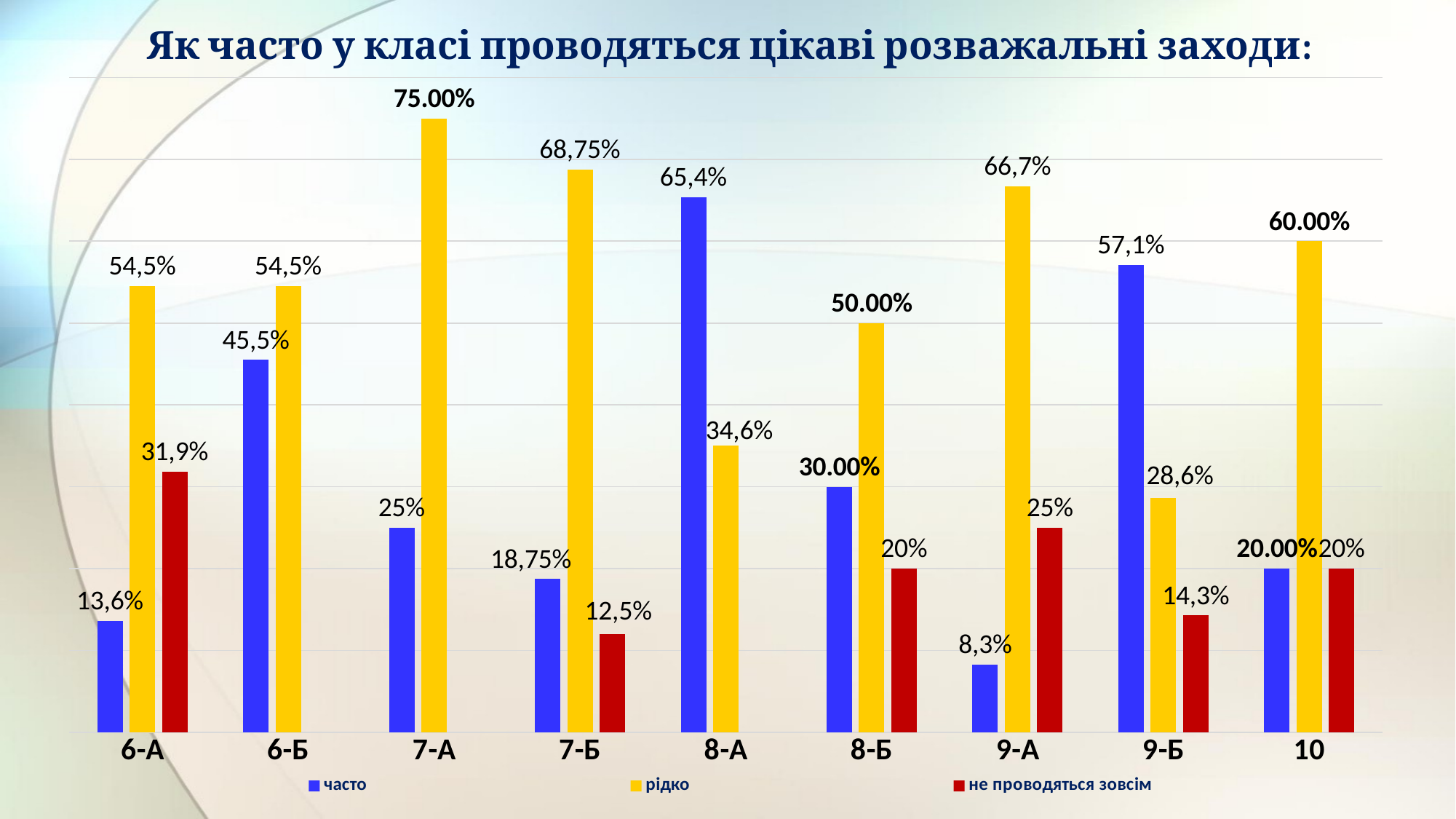
What is the value of the 'рідко' series for class 9-А? 66,7% Which class has the lowest value in the 'часто' series? 9-А For class 7-Б, what is the difference between the 'рідко' value and the 'часто' value? 50 percentage points How many series does the legend list? 3 Which class has the highest value in the 'рідко' series? 7-А Which colour represents the 'рідко' series in the chart? Yellow What is the value of the 'не проводяться зовсім' series for class 9-Б? 14,3% For class 8-А, which is larger: the 'часто' value or the 'рідко' value? часто How many classes are shown on the x axis? 9 What is the value of the 'не проводяться зовсім' series for class 6-А? 31,9% What kind of chart is shown on the slide? Bar chart What is the value of the 'часто' series for class 6-А? 13,6%